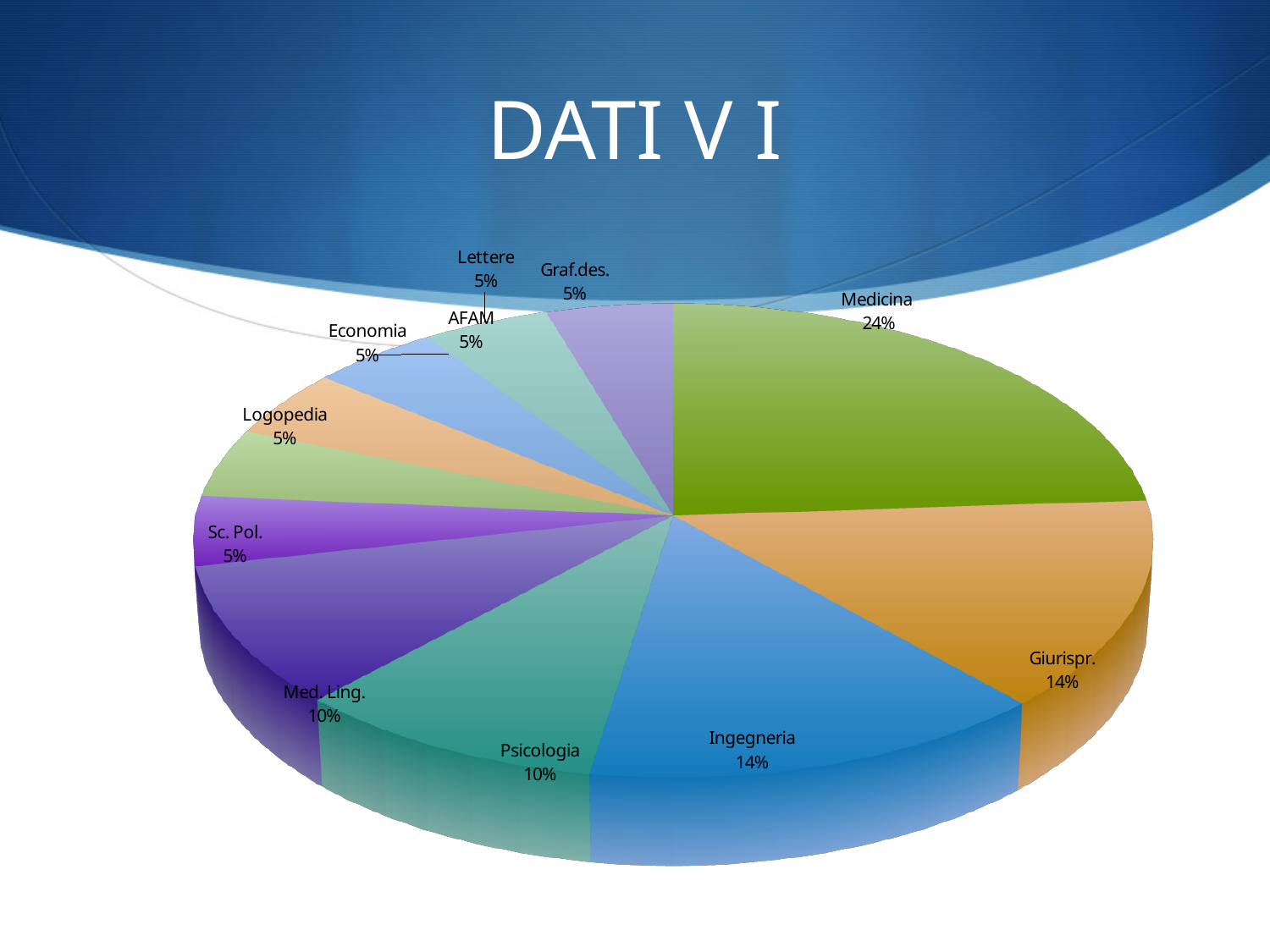
Which has a larger share, Ingegneria or Psicologia? Ingegneria What kind of chart is shown on the slide? Pie chart What percentage is shown for Giurispr.? 14% What is the difference in percentage points between Medicina and Ingegneria? 10 percentage points What colour is the Medicina slice? Green How many categories are labelled on the pie chart? 11 What percentage is shown for Psicologia? 10% What share of the pie does Med. Ling. account for? 10% What is the title of the slide? DATI V I What percentage does the Medicina slice represent? 24% What percentage is shown for Logopedia? 5% Which category has the largest share of the pie? Medicina